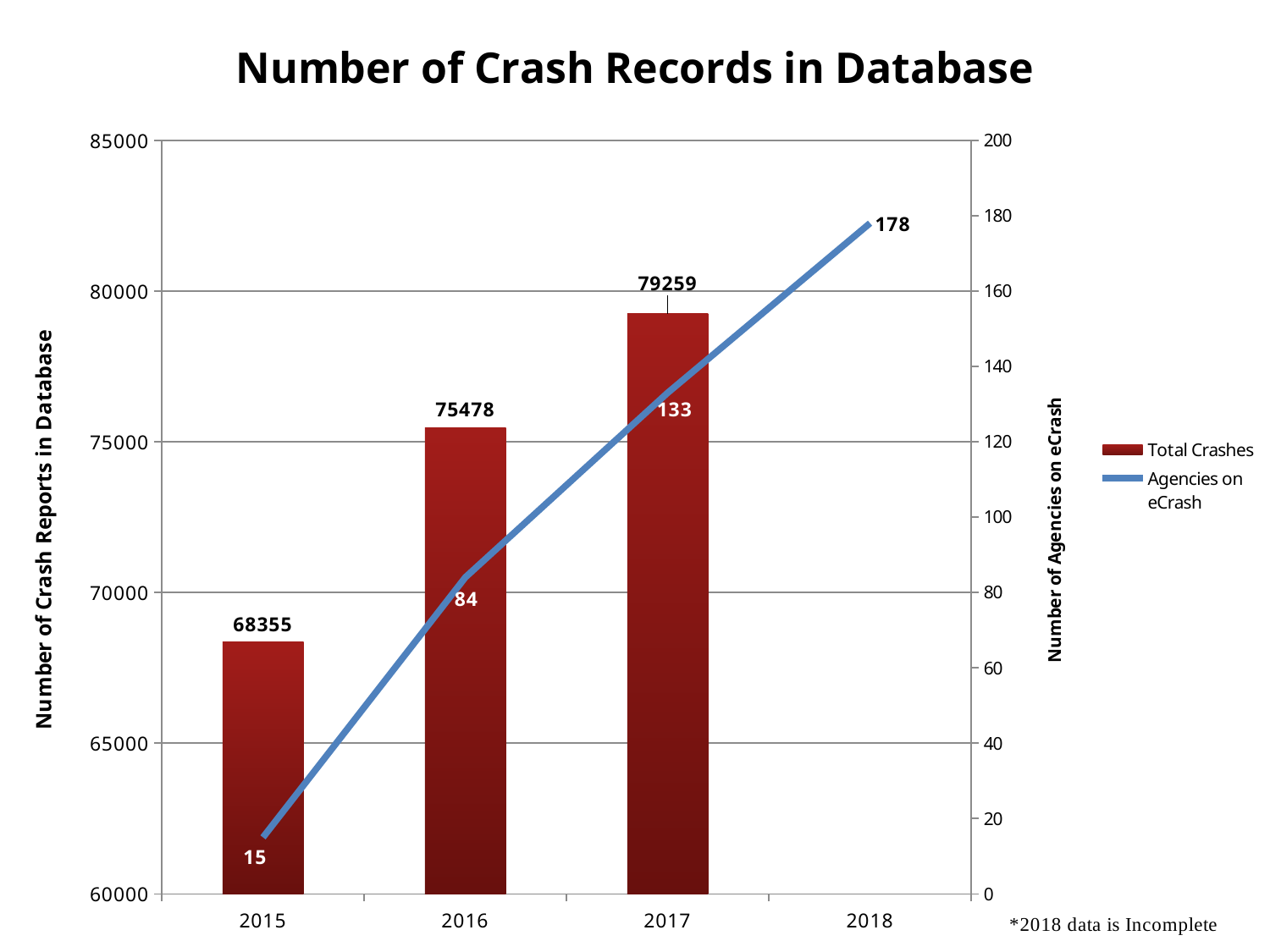
How many series does the legend list? 2 How many years are shown on the x axis? 4 What is the difference in Agencies on eCrash between 2017 and 2016? 49 Does the Agencies on eCrash line rise or fall from 2015 to 2018? rise Which year has the lowest number of Agencies on eCrash? 2015 What is the value of Total Crashes for 2016? 75478 What is the value of Total Crashes for 2015? 68355 Which is larger, Total Crashes in 2015 or in 2016? 2016 What is the title of the chart? Number of Crash Records in Database What is the difference in Total Crashes between 2017 and 2016? 3781 Which year has the highest Total Crashes value? 2017 How many Agencies on eCrash are shown for 2018? 178